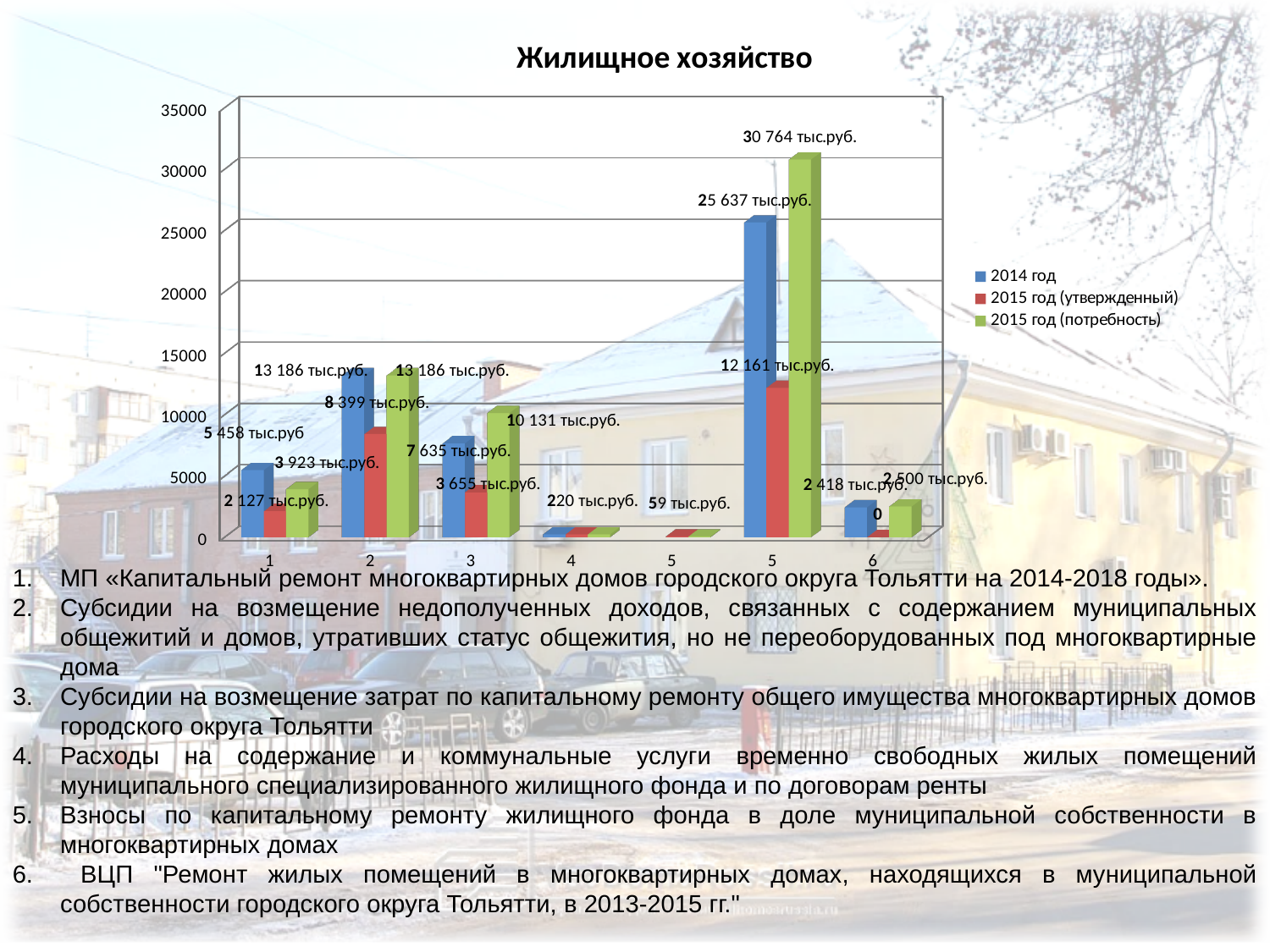
What is the title of the chart? Жилищное хозяйство How many series does the chart legend list? 3 What are the three series named in the legend? 2014 год; 2015 год (утвержденный); 2015 год (потребность) Is the 2014 год value for category 4 greater or less than 5000? less What is the highest value labelled on the chart? 30 764 тыс.руб. What is the 2014 год value for category 1? 5 458 тыс.руб What is the 2015 год (утвержденный) value for category 6? 0 What is the 2015 год (потребность) value for category 3? 10 131 тыс.руб. What type of chart is shown on the slide? Bar chart What is the difference between the 2014 год value and the 2015 год (утвержденный) value for category 1? 3 331 тыс.руб. What is the 2015 год (утвержденный) value for category 2? 8 399 тыс.руб. For category 3, which is larger: the 2014 год value or the 2015 год (потребность) value? 2015 год (потребность)